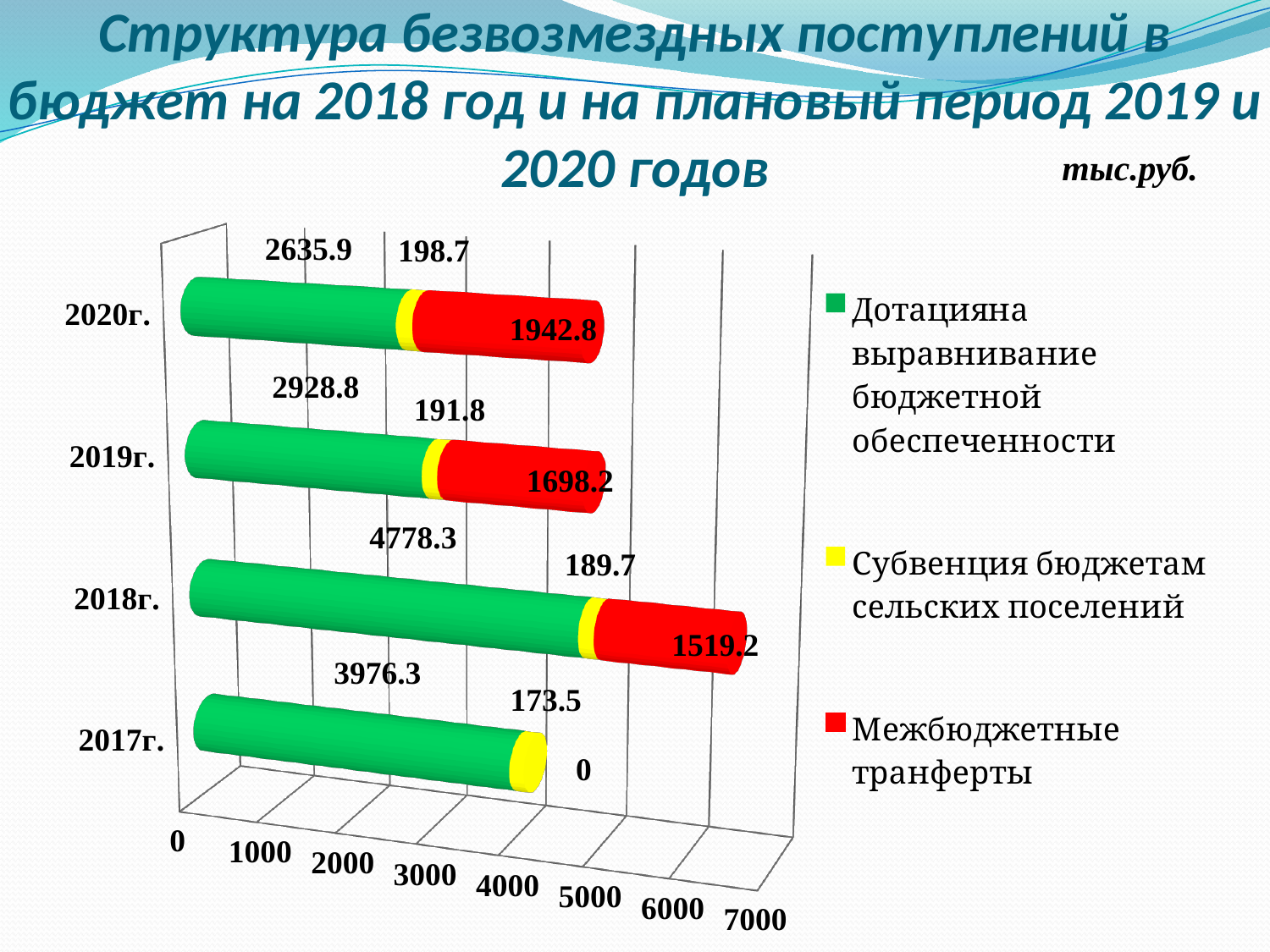
What is the total of the stacked bar for 2018г.? 6487.2 What kind of chart is shown on the slide? Stacked bar chart Which year has the highest value of Дотация на выравнивание бюджетной обеспеченности? 2018г. How many years (categories) are shown on the chart? 4 What is the value of Межбюджетные трансферты for 2017г.? 0 What is the value of Дотация на выравнивание бюджетной обеспеченности for 2018г.? 4778.3 Which year has the lowest value of Субвенция бюджетам сельских поселений? 2017г. How many series does the legend list? 3 Which is larger: Межбюджетные трансферты for 2019г. or for 2018г.? 2019г. What is the value of Субвенция бюджетам сельских поселений for 2017г.? 173.5 What is the difference between the Дотация values for 2019г. and 2020г.? 292.9 What is the value of Межбюджетные трансферты for 2020г.? 1942.8